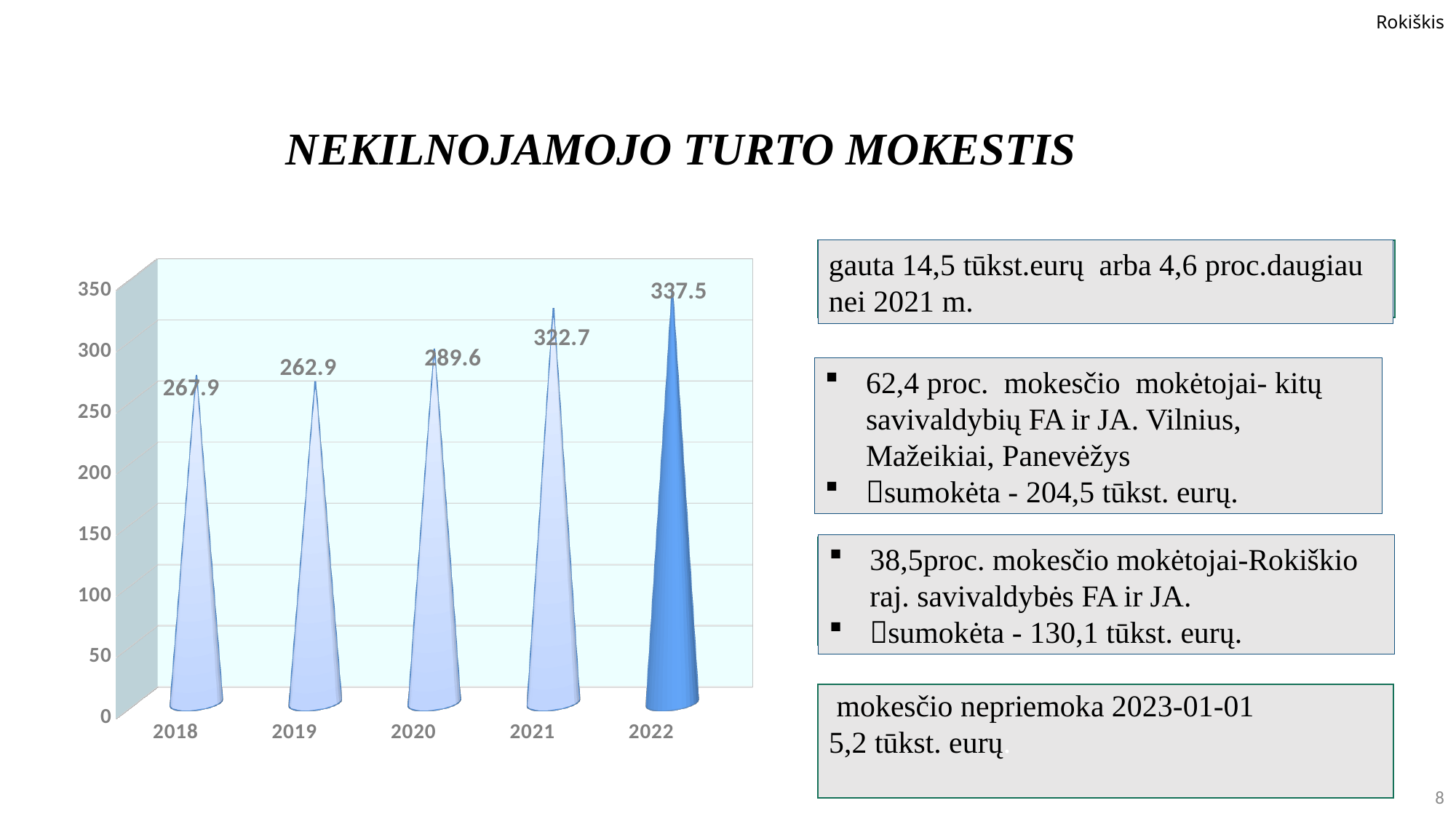
Which year has the lowest value? 2019 What is the value for 2022? 337.5 What is the difference between the values for 2022 and 2021? 14.8 What is the value for 2020? 289.6 Which is larger, the value for 2020 or the value for 2021? 2021 How many years are shown on the x axis? 5 Is the value for 2021 greater or less than 300? greater Which year has the highest value? 2022 What is the value for 2018? 267.9 What kind of chart is shown on the slide? bar chart What is the difference between the values for 2018 and 2019? 5 Do the values generally rise or fall from 2019 to 2022? rise